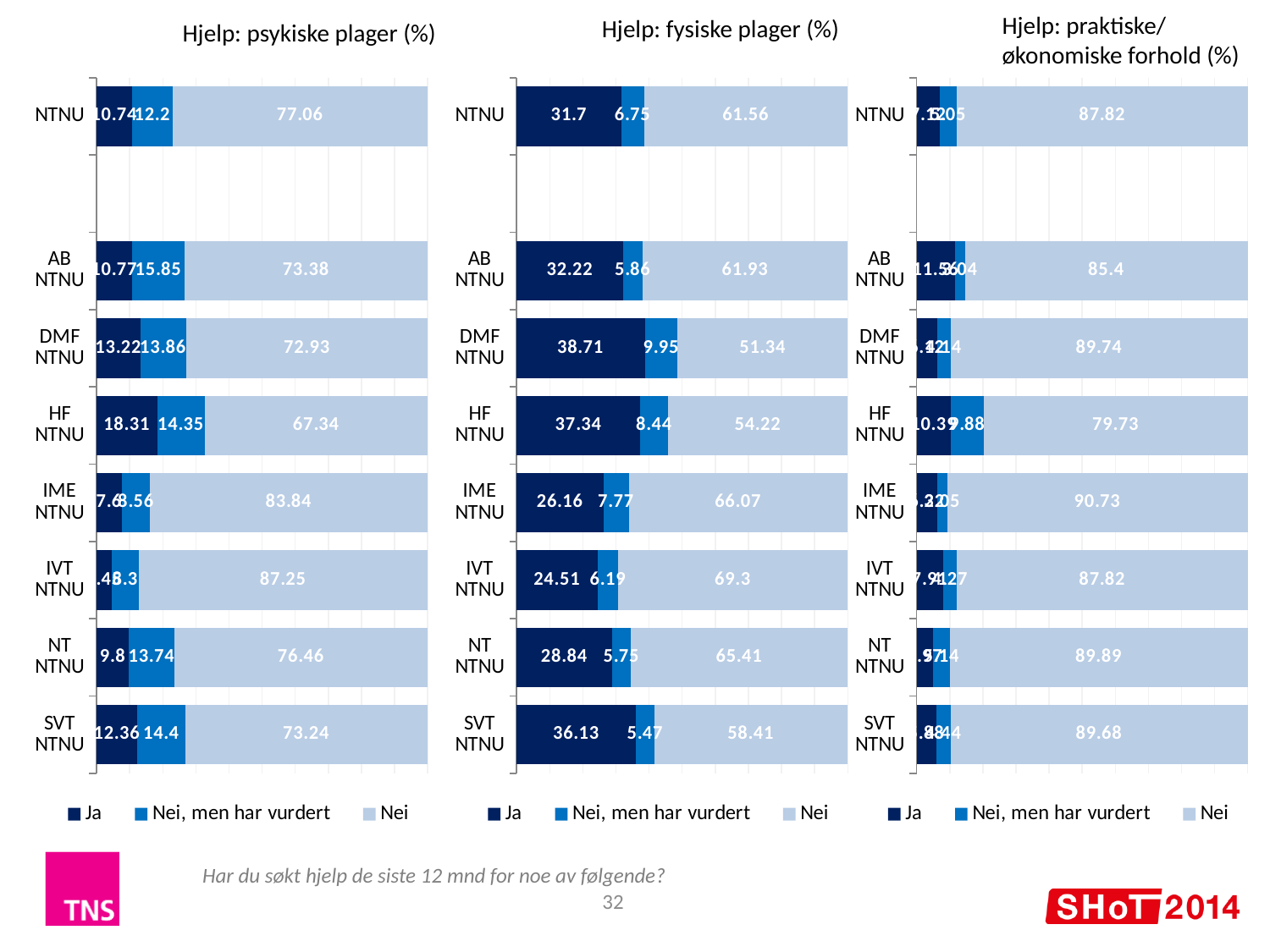
How many categories are shown in the 'Hjelp: psykiske plager (%)' chart? 8 In the 'Hjelp: praktiske/økonomiske forhold (%)' chart, what is the 'Nei' value for IME NTNU? 90.73 How many series does the legend of the 'Hjelp: fysiske plager (%)' chart list? 3 In the 'Hjelp: praktiske/økonomiske forhold (%)' chart, which category has the lowest 'Nei' value? HF NTNU In the 'Hjelp: fysiske plager (%)' chart, what is the difference between the 'Nei' values for IVT NTNU and DMF NTNU? 17.96 In the 'Hjelp: fysiske plager (%)' chart, what is the 'Ja' value for DMF NTNU? 38.71 In the 'Hjelp: psykiske plager (%)' chart, what is the 'Nei' value for HF NTNU? 67.34 In the 'Hjelp: fysiske plager (%)' chart, what is the 'Nei, men har vurdert' value for NTNU? 6.75 In the 'Hjelp: fysiske plager (%)' chart, which category has the highest 'Ja' value? DMF NTNU In the 'Hjelp: psykiske plager (%)' chart, which is larger: the 'Ja' value for HF NTNU or for SVT NTNU? HF NTNU What kind of chart is 'Hjelp: praktiske/økonomiske forhold (%)'? Stacked bar chart In the 'Hjelp: psykiske plager (%)' chart, which category has the lowest 'Nei' value? HF NTNU